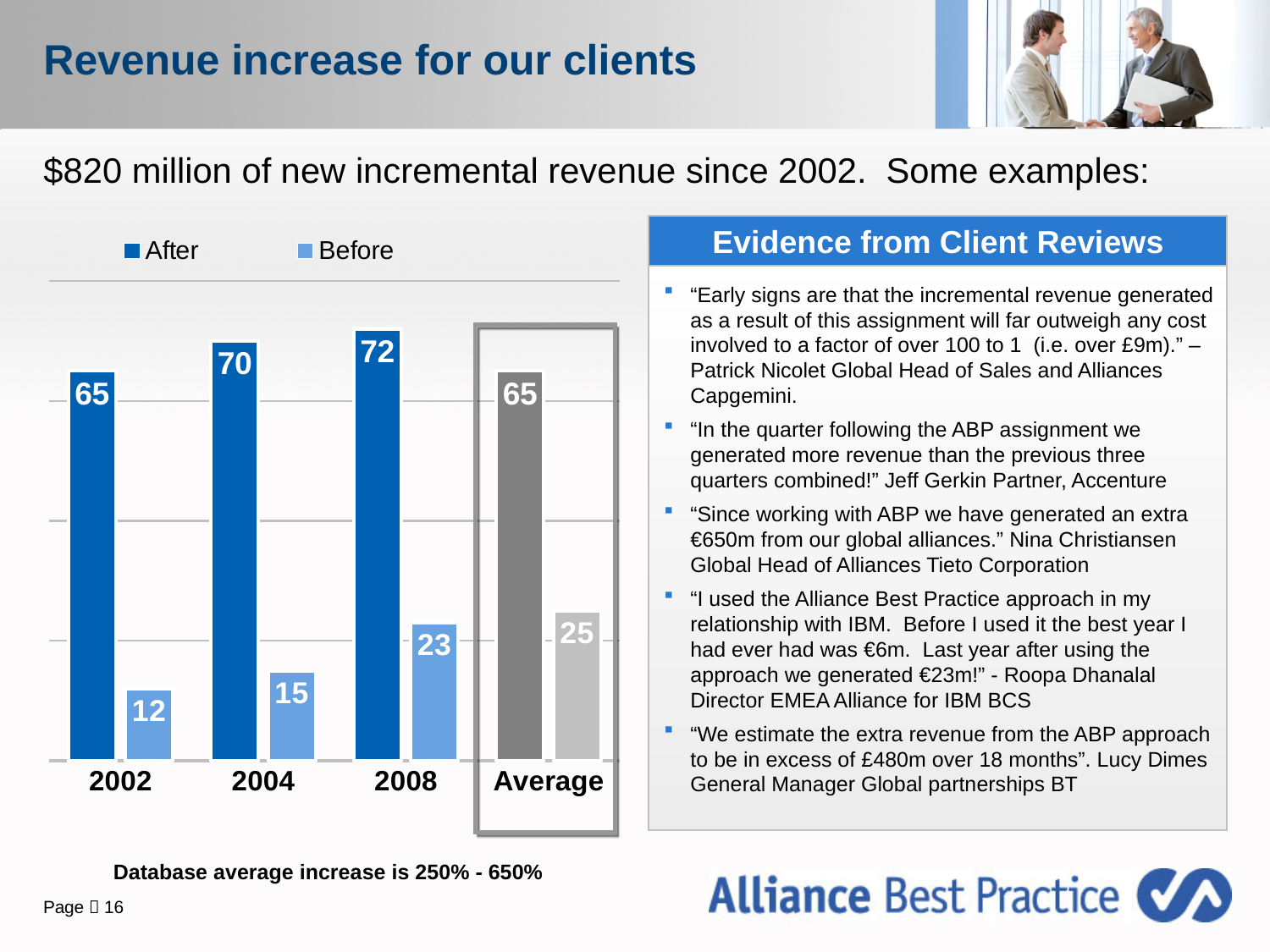
What is the 'Before' value for the Average category? 25 What is the 'After' value for 2004? 70 What is the difference between the 'After' and 'Before' values for 2002? 53 What is the difference between the 'After' values for 2008 and 2004? 2 How many categories are shown on the x axis of the chart? 4 Which is larger, the 'Before' value for 2004 or the 'Before' value for 2008? 2008 How many series does the chart legend list? 2 Which category has the lowest 'Before' value? 2002 Which category has the highest 'After' value? 2008 Do the 'Before' values rise or fall from 2002 to 2008? Rise What kind of chart is shown on the slide? Bar chart What is the 'Before' value for 2008? 23